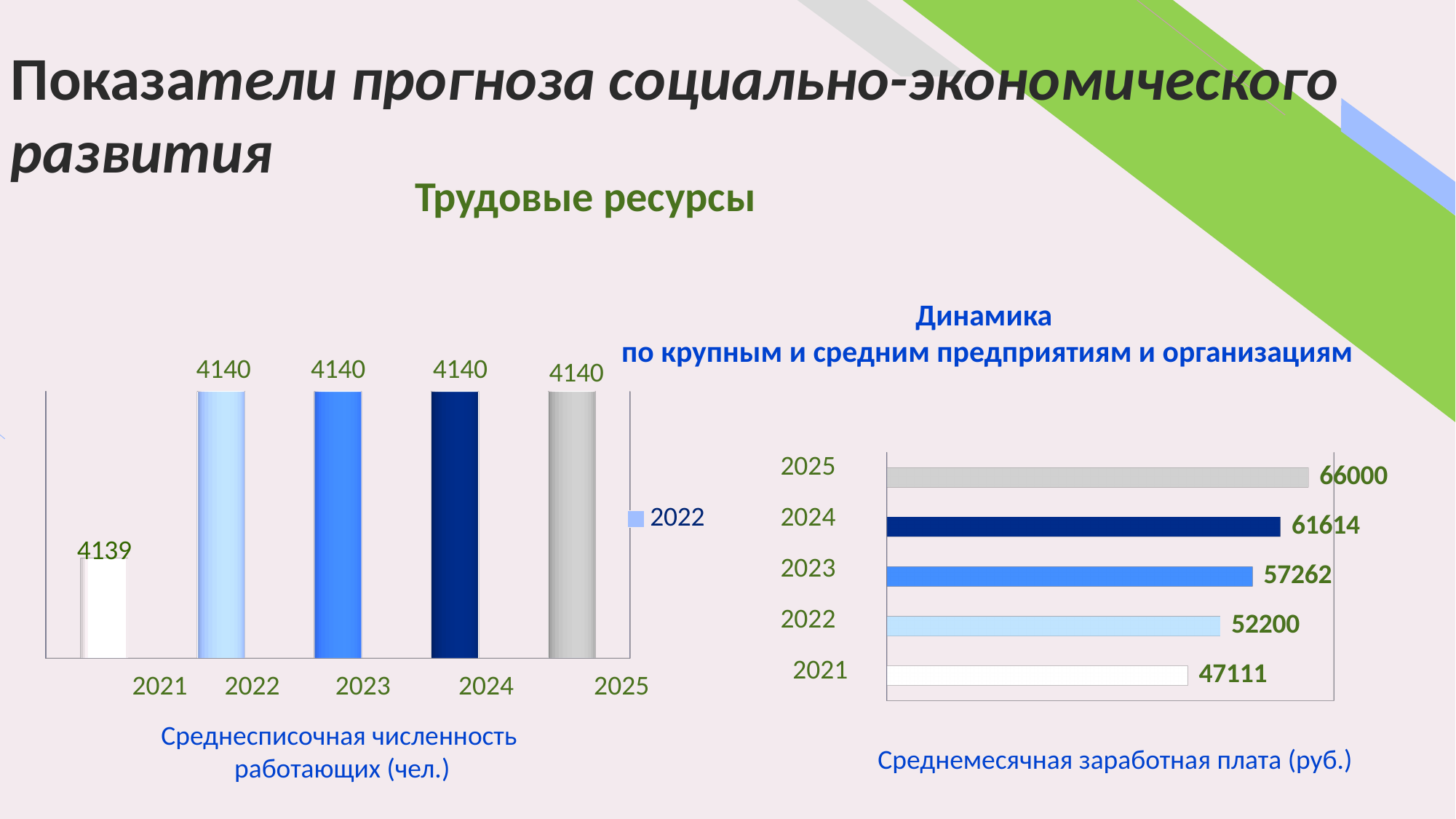
In the right chart (Среднемесячная заработная плата), what is the difference between the values for 2025 and 2024? 4386 In the right chart (Среднемесячная заработная плата), what is the value for 2021? 47111 In the right chart (Среднемесячная заработная плата), do the values rise or fall from 2021 to 2025? rise In the left chart (Среднесписочная численность работающих), what is the value for 2021? 4139 In the left chart (Среднесписочная численность работающих), which year has the lowest value? 2021 What is the title of the right chart on the slide? Динамика по крупным и средним предприятиям и организациям In the left chart (Среднесписочная численность работающих), how many years are shown on the x axis? 5 In the left chart (Среднесписочная численность работающих), what is the value for 2024? 4140 In the right chart (Среднемесячная заработная плата), which year has the highest value? 2025 In the right chart (Среднемесячная заработная плата), which is larger, the value for 2022 or the value for 2023? 2023 What kind of chart is the left chart (Среднесписочная численность работающих)? bar chart In the right chart (Среднемесячная заработная плата), what is the value for 2023? 57262